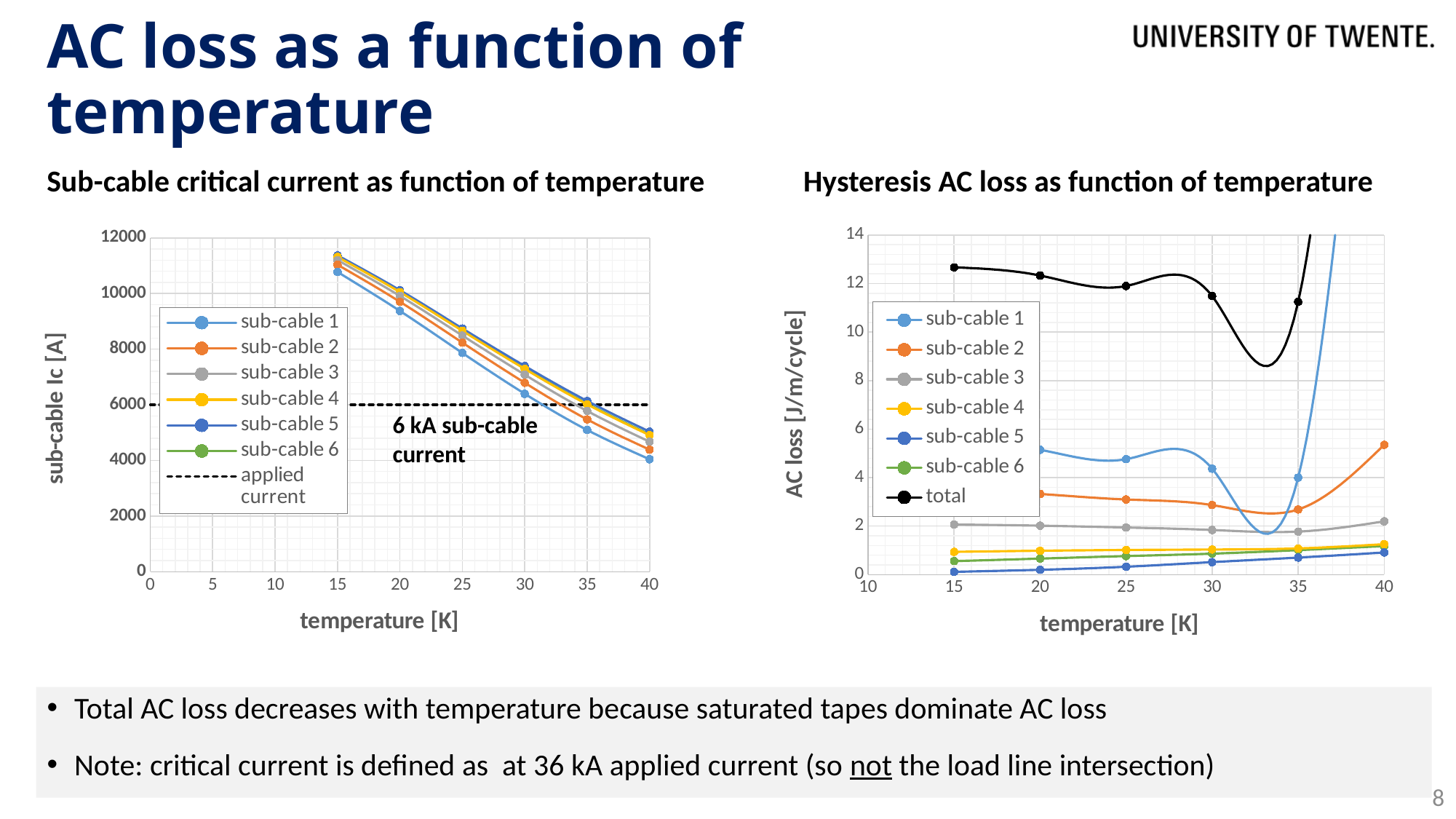
In the 'Hysteresis AC loss as function of temperature' chart, which is larger at 20 K, sub-cable 1 or sub-cable 2? sub-cable 1 In the 'Hysteresis AC loss as function of temperature' chart, which series has the highest AC loss at 15 K? total In the 'Hysteresis AC loss as function of temperature' chart, is the value for total at 15 K greater or less than 12? greater How many entries does the legend of the 'Sub-cable critical current as function of temperature' chart list? 7 What kind of chart is the 'Sub-cable critical current as function of temperature' chart? line chart In the 'Sub-cable critical current as function of temperature' chart, do the sub-cable Ic values rise or fall as temperature increases? fall In the 'Sub-cable critical current as function of temperature' chart, which sub-cable has the lowest Ic at 40 K? sub-cable 1 In the 'Hysteresis AC loss as function of temperature' chart, is the value for sub-cable 5 at 15 K greater or less than 1? less In the 'Sub-cable critical current as function of temperature' chart, how many temperature points are plotted for each sub-cable? 6 In the 'Sub-cable critical current as function of temperature' chart, is the value for sub-cable 1 at 15 K greater or less than 10000? greater How many entries does the legend of the 'Hysteresis AC loss as function of temperature' chart list? 7 In the 'Sub-cable critical current as function of temperature' chart, what does the dashed black line represent? applied current